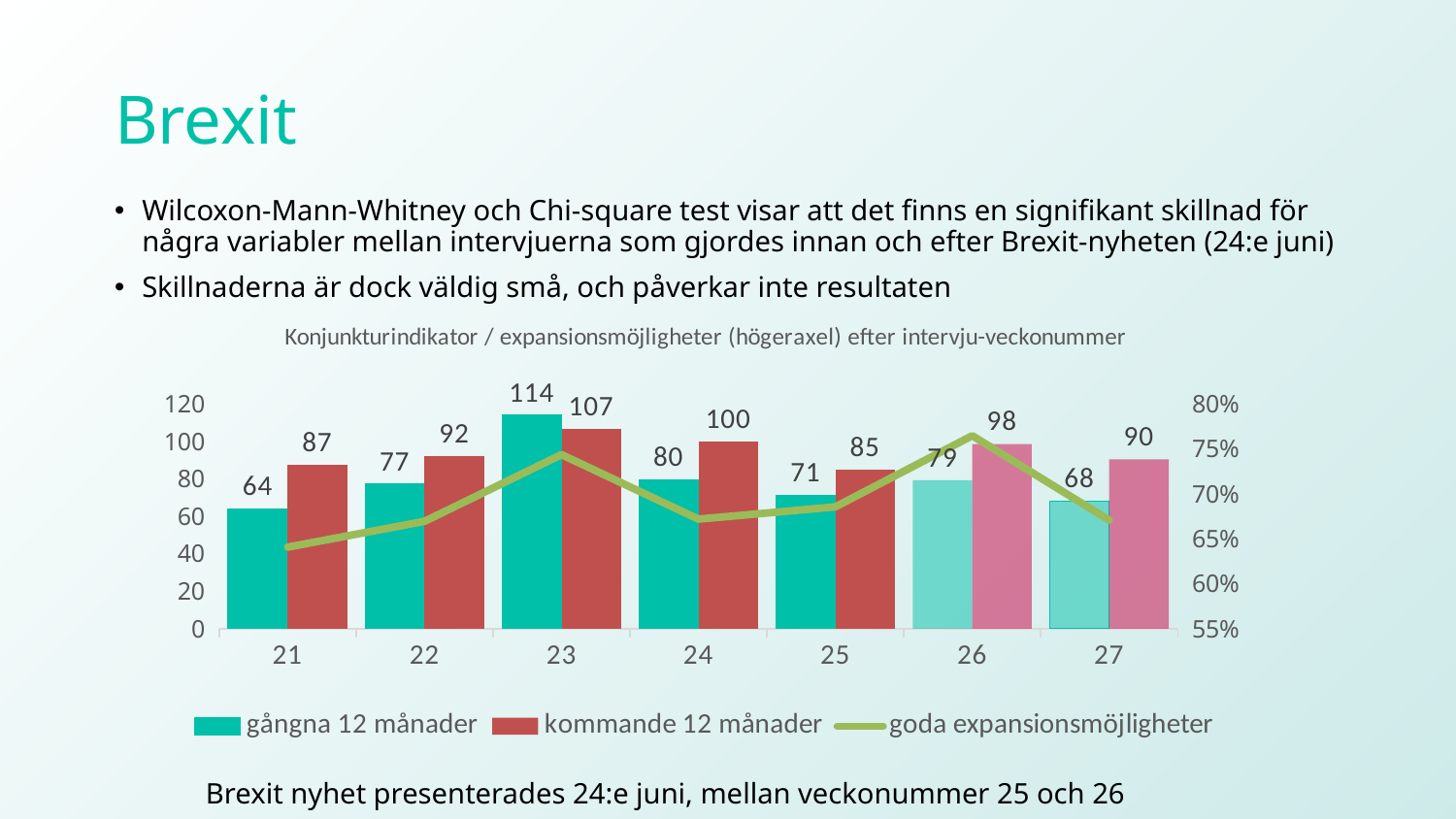
What is the value for 'kommande 12 månader' in week 24? 100 Which series is plotted on the right axis? goda expansionsmöjligheter Which week has the highest value for 'kommande 12 månader'? 23 How many week numbers are shown on the x axis? 7 Which is larger in week 26: 'gångna 12 månader' or 'kommande 12 månader'? kommande 12 månader What kind of chart is this? Bar chart with a line Is the value of 'goda expansionsmöjligheter' in week 21 greater or less than 70%? less Is the value of 'goda expansionsmöjligheter' in week 26 greater or less than 70%? greater Which week has the lowest value for 'gångna 12 månader'? 21 What is the value for 'gångna 12 månader' in week 23? 114 What is the difference between 'kommande 12 månader' and 'gångna 12 månader' in week 21? 23 How many series does the legend list? 3